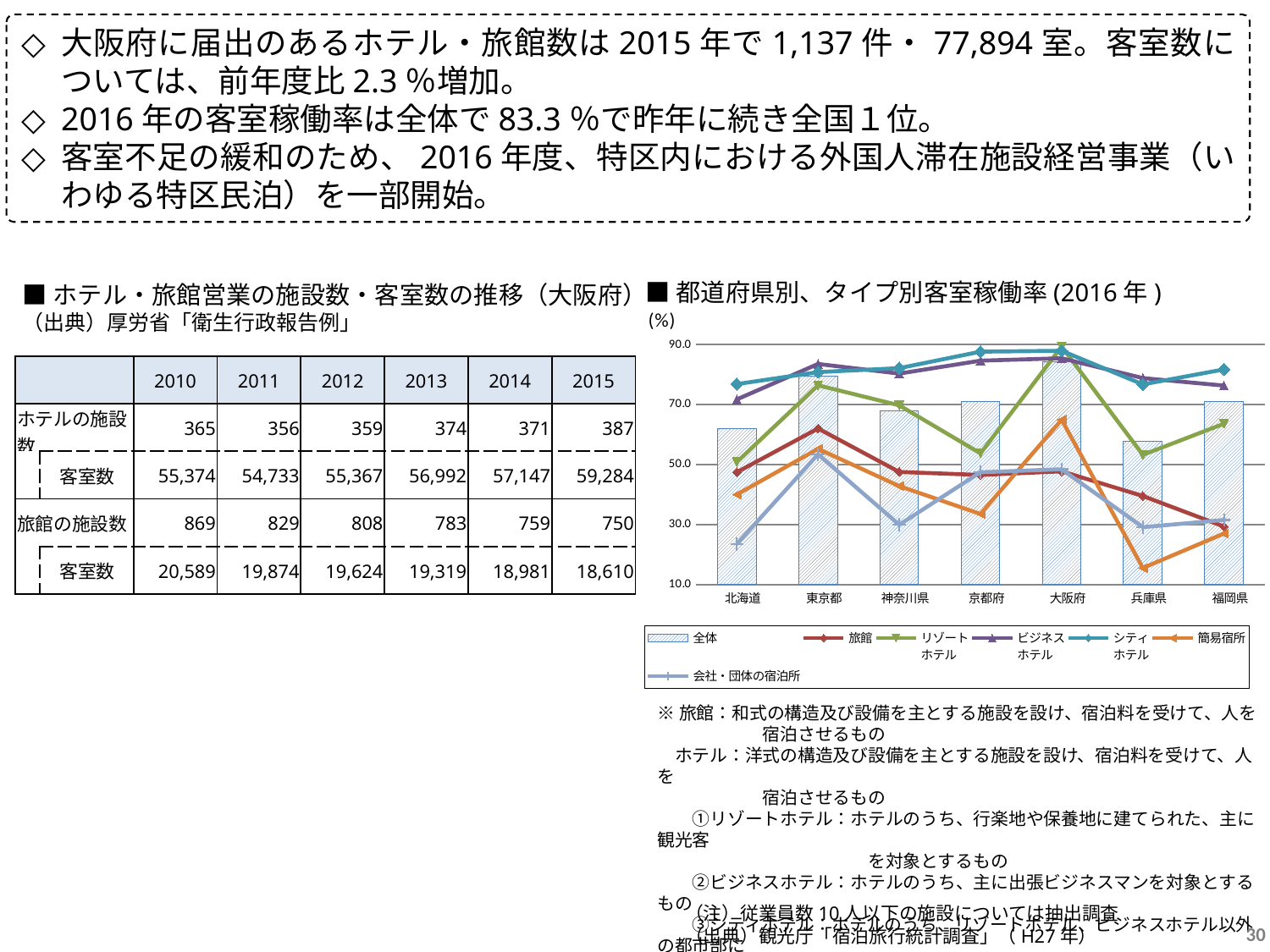
How many series does the legend of the 都道府県別、タイプ別客室稼働率 chart list? 7 In the 都道府県別、タイプ別客室稼働率 chart, is the 全体 value for 大阪府 greater or less than 70.0? greater What kind of chart is the 都道府県別、タイプ別客室稼働率 (2016年) chart? A combined bar and line chart In the 都道府県別、タイプ別客室稼働率 chart, which is larger, the 全体 value for 大阪府 or for 東京都? 大阪府 In the 都道府県別、タイプ別客室稼働率 chart, is the シティホテル value for 京都府 greater or less than 70.0? greater In the 都道府県別、タイプ別客室稼働率 chart, which prefecture has the highest 簡易宿所 value? 大阪府 How many prefectures are shown on the x axis of the 都道府県別、タイプ別客室稼働率 chart? 7 In the 都道府県別、タイプ別客室稼働率 chart, does the 簡易宿所 line rise or fall from 大阪府 to 兵庫県? fall In the 都道府県別、タイプ別客室稼働率 chart, which prefecture has the highest 全体 bar? 大阪府 In the 都道府県別、タイプ別客室稼働率 chart, is the 全体 value for 北海道 greater or less than 70.0? less In the 都道府県別、タイプ別客室稼働率 chart, which prefecture has the lowest 簡易宿所 value? 兵庫県